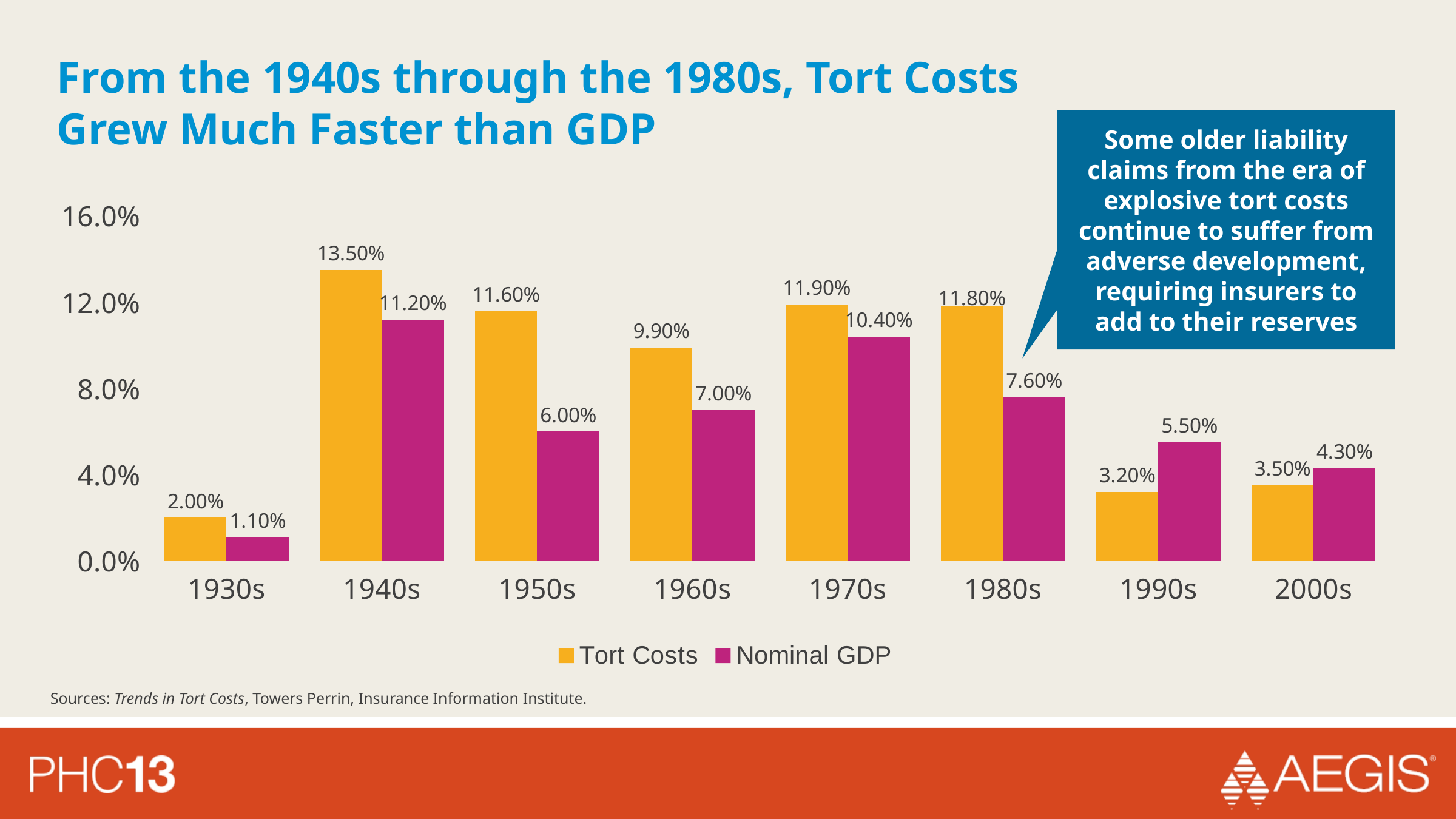
Which colour represents Nominal GDP in the chart? Magenta How many series does the legend list? 2 Which decade has the highest Tort Costs value? 1940s How many decades are shown on the x axis? 8 In the 2000s, which is larger: Tort Costs or Nominal GDP? Nominal GDP What is the Tort Costs value for the 1990s? 3.20% Which decade has the lowest Nominal GDP value? 1930s Is the Tort Costs value for the 1960s greater or less than 8.0%? greater What is the difference between Tort Costs and Nominal GDP in the 1950s? 5.60% What is the Tort Costs value for the 1940s? 13.50% What kind of chart is shown on the slide? Bar chart What is the Nominal GDP value for the 1980s? 7.60%